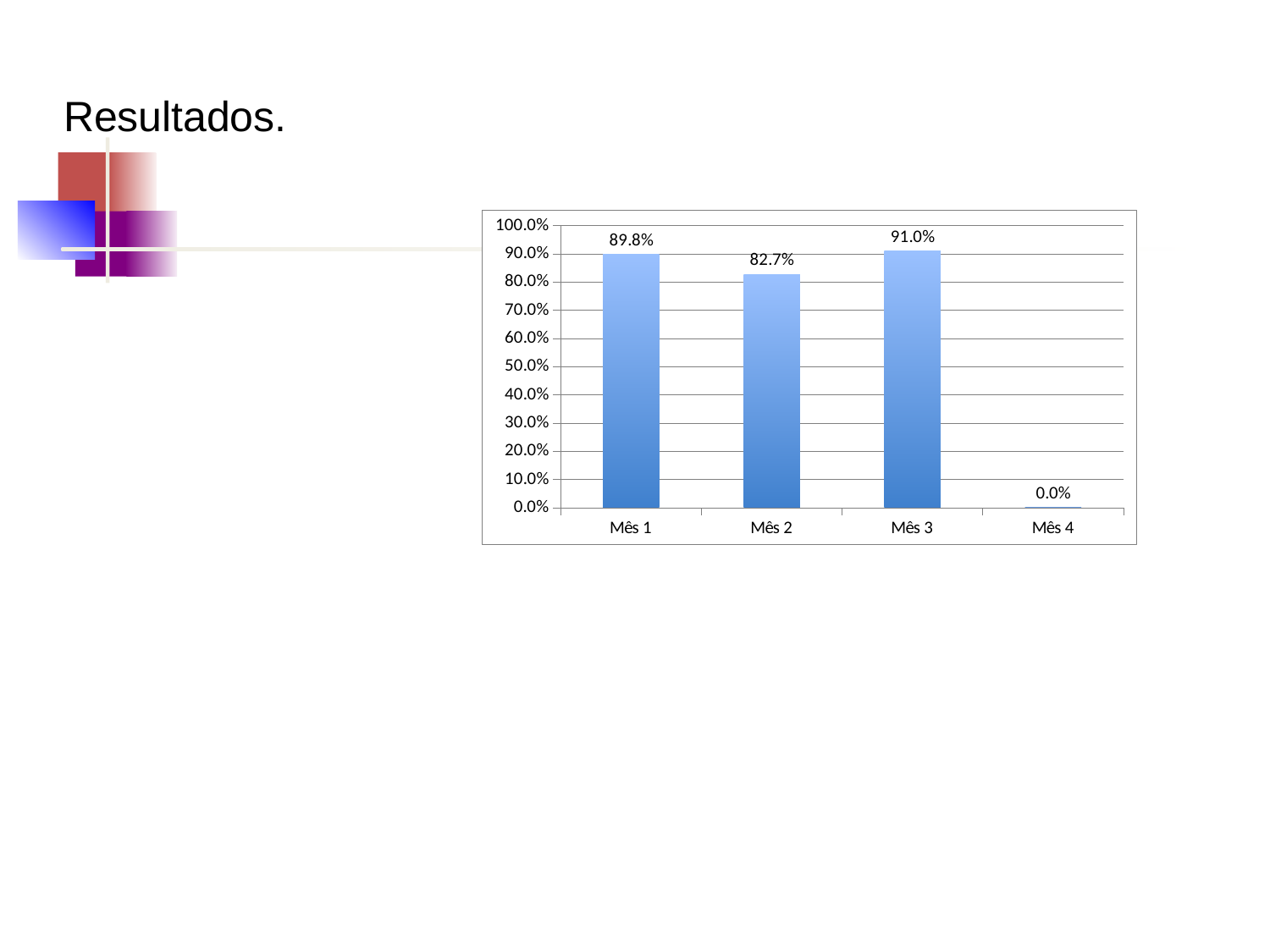
What kind of chart is shown on the slide? bar chart What is the value for Mês 3? 91.0% What is the value for Mês 4? 0.0% What is the difference between the values for Mês 3 and Mês 2? 8.3% What is the value for Mês 2? 82.7% Which is larger, the value for Mês 1 or the value for Mês 2? Mês 1 Which category has the lowest value? Mês 4 How many categories are shown on the x axis? 4 Is the value for Mês 2 greater or less than 90.0%? less What is the difference between the values for Mês 1 and Mês 2? 7.1% What is the value for Mês 1? 89.8% Which category has the highest value? Mês 3